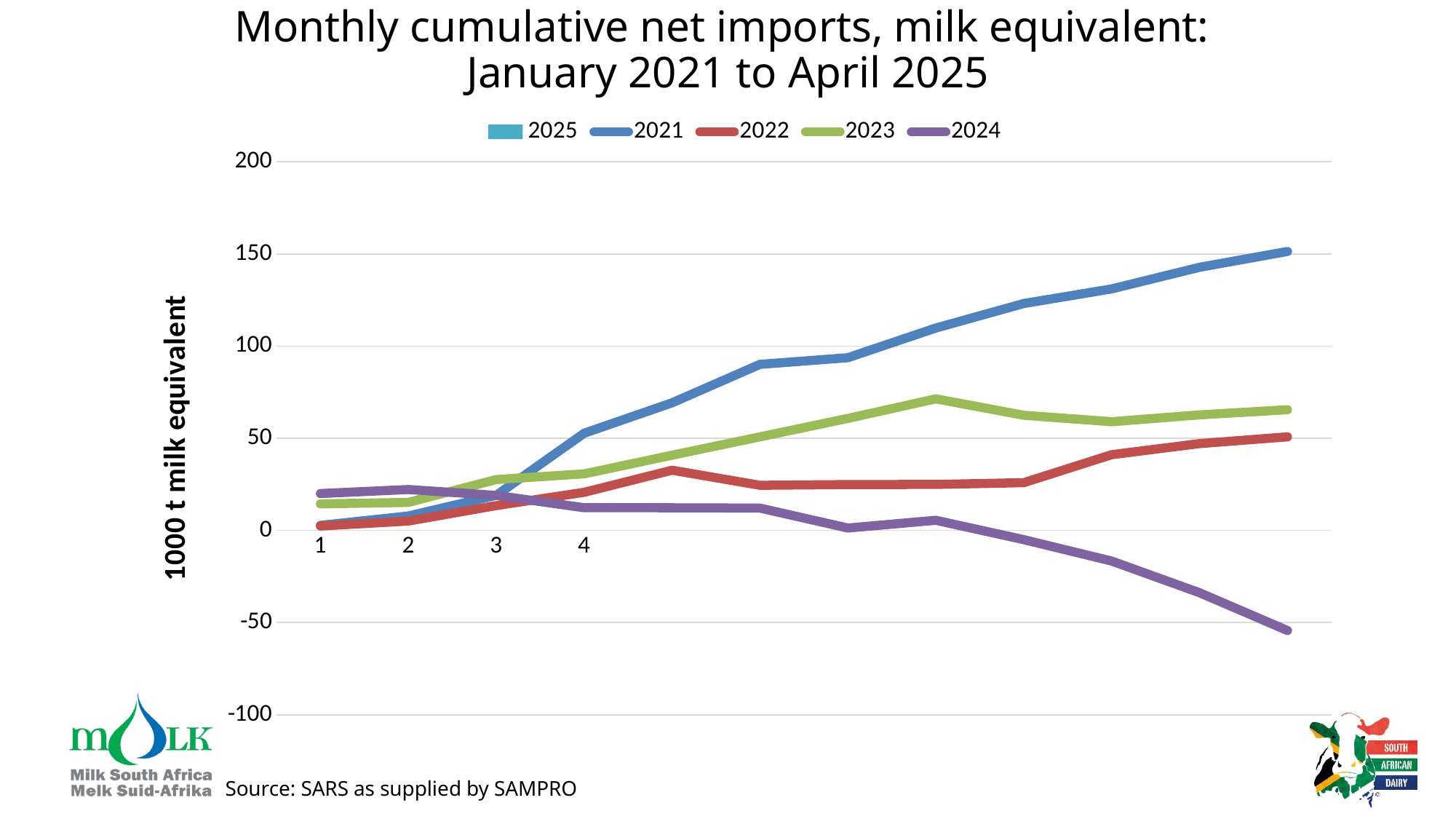
Which series ends at the highest value at the right end of the chart? 2021 Is the final value of the 2023 line greater or less than 50? greater What is the label on the vertical axis? 1000 t milk equivalent What kind of chart is shown on the slide? line chart What is the title of the chart? Monthly cumulative net imports, milk equivalent: January 2021 to April 2025 Is the final value of the 2024 line greater or less than 0? less At the right end of the chart, which is larger: the 2023 value or the 2022 value? 2023 Is the final value of the 2022 line greater or less than 100? less Does the 2021 line rise or fall along the x axis? rise How many series does the legend list? 5 Which series ends at the lowest value at the right end of the chart? 2024